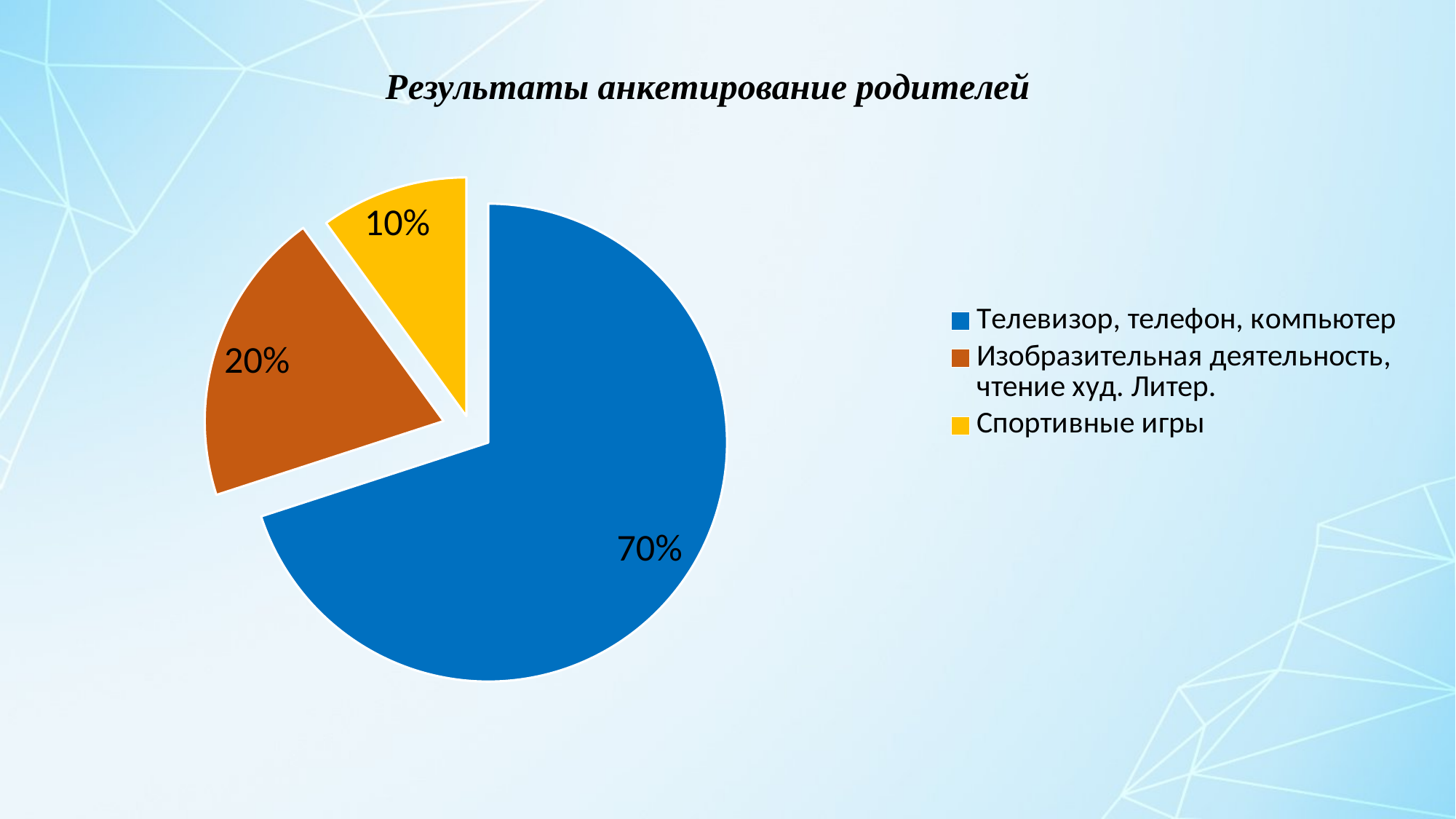
Which category has the largest slice of the pie? Телевизор, телефон, компьютер Which category has the smallest slice of the pie? Спортивные игры How many slices does the pie chart have? 3 What share of the pie does "Изобразительная деятельность, чтение худ. Литер." take? 20% What share of the pie does "Спортивные игры" take? 10% What colour is the slice for "Спортивные игры"? yellow What is the difference between the shares of "Телевизор, телефон, компьютер" and "Изобразительная деятельность, чтение худ. Литер."? 50% What share of the pie does "Телевизор, телефон, компьютер" take? 70% Which is larger: the share for "Изобразительная деятельность, чтение худ. Литер." or the share for "Спортивные игры"? Изобразительная деятельность, чтение худ. Литер. What type of chart is shown on the slide? pie chart What is the difference between the shares of "Изобразительная деятельность, чтение худ. Литер." and "Спортивные игры"? 10% What is the title of the chart? Результаты анкетирование родителей